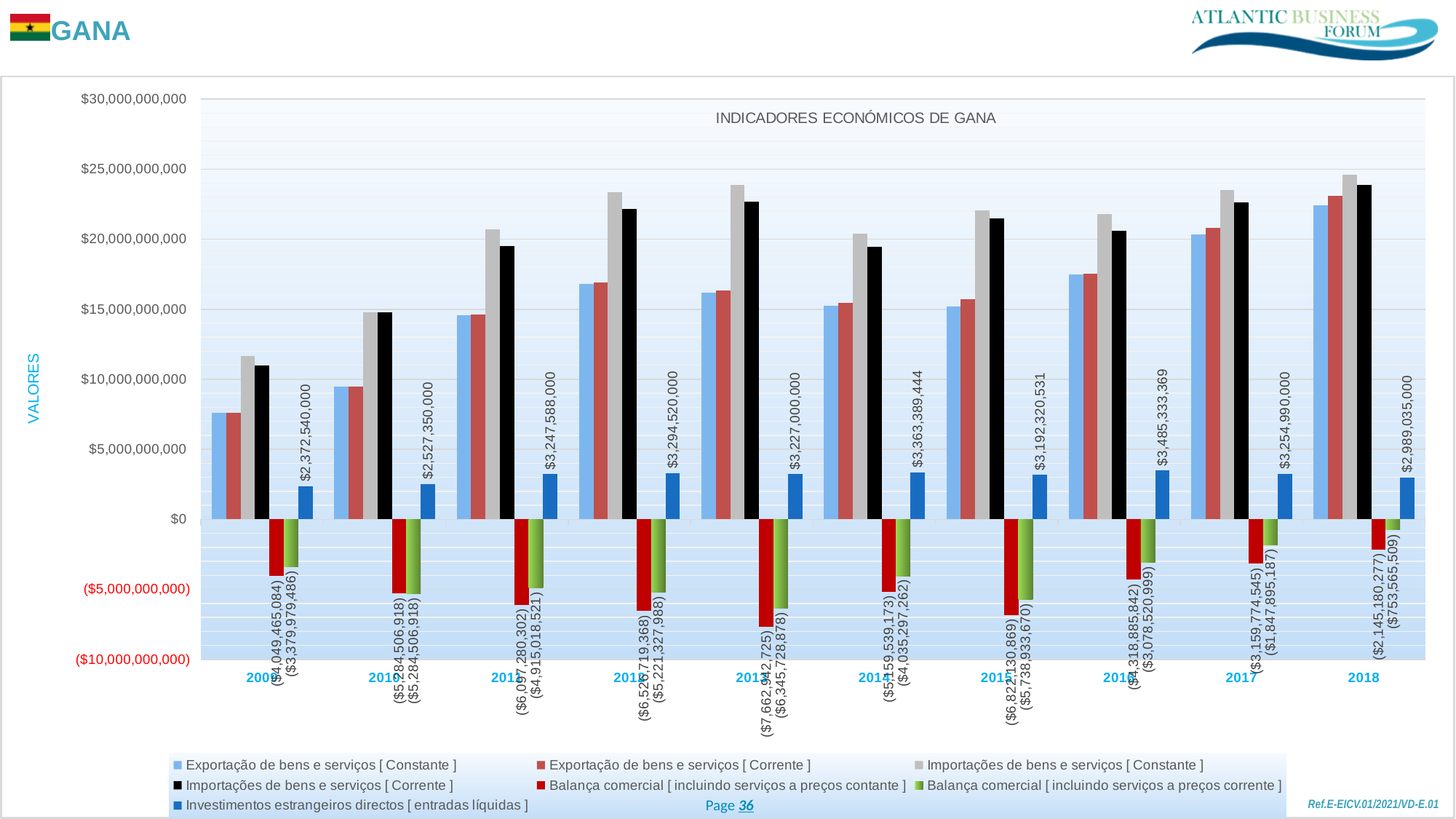
What is the value of Balança comercial [incluindo serviços a preços contante] for 2013? ($7,662,942,725) In which year is Investimentos estrangeiros directos [entradas líquidas] highest? 2016 Is the value of Importações de bens e serviços [Constante] for 2018 greater or less than $20,000,000,000? greater What is the value of Investimentos estrangeiros directos [entradas líquidas] for 2016? $3,485,333,369 What is the value of Balança comercial [incluindo serviços a preços corrente] for 2018? ($753,565,509) What is the title of the chart? INDICADORES ECONÓMICOS DE GANA What type of chart is shown on the slide? Bar chart How many years are shown on the x axis of the chart? 10 In which year is Investimentos estrangeiros directos [entradas líquidas] lowest? 2009 How many series does the legend list? 7 Which year has the larger value for Importações de bens e serviços [Constante], 2013 or 2014? 2013 What is the difference between Investimentos estrangeiros directos in 2016 and in 2009? $1,112,793,369